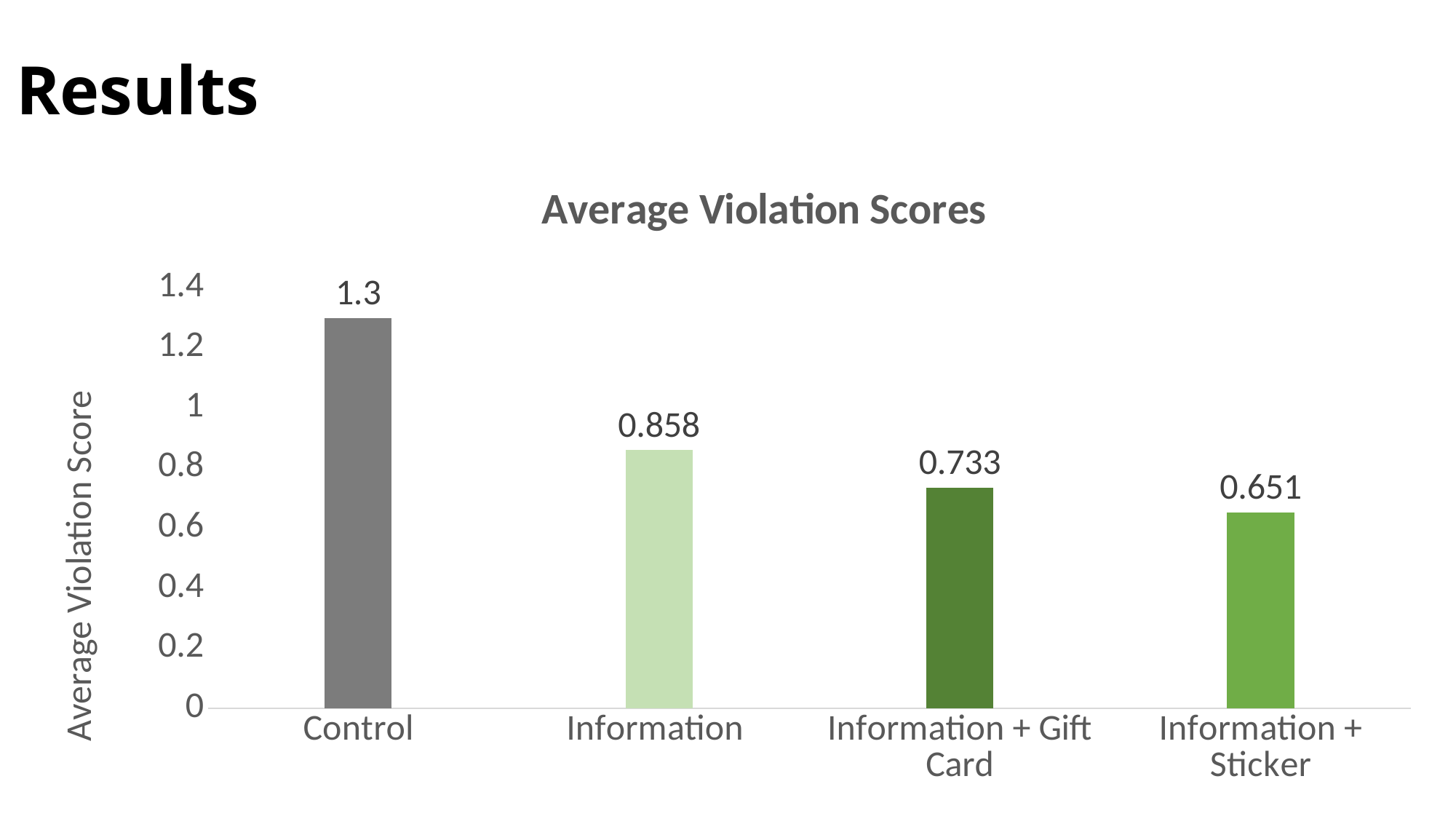
What is the average violation score for the Control group? 1.3 What is the title of the chart? Average Violation Scores Which group has the lowest average violation score? Information + Sticker What is the difference between the average violation scores of the Control and Information groups? 0.442 How many groups are shown in the chart? 4 Is the value for Information + Sticker greater or less than 0.8? less What kind of chart is shown on the slide? Bar chart What is the difference between the average violation scores of the Information + Gift Card and Information + Sticker groups? 0.082 Which has a higher average violation score, Information or Information + Gift Card? Information What is the average violation score for the Information + Sticker group? 0.651 What is the average violation score for the Information + Gift Card group? 0.733 Which group has the highest average violation score? Control